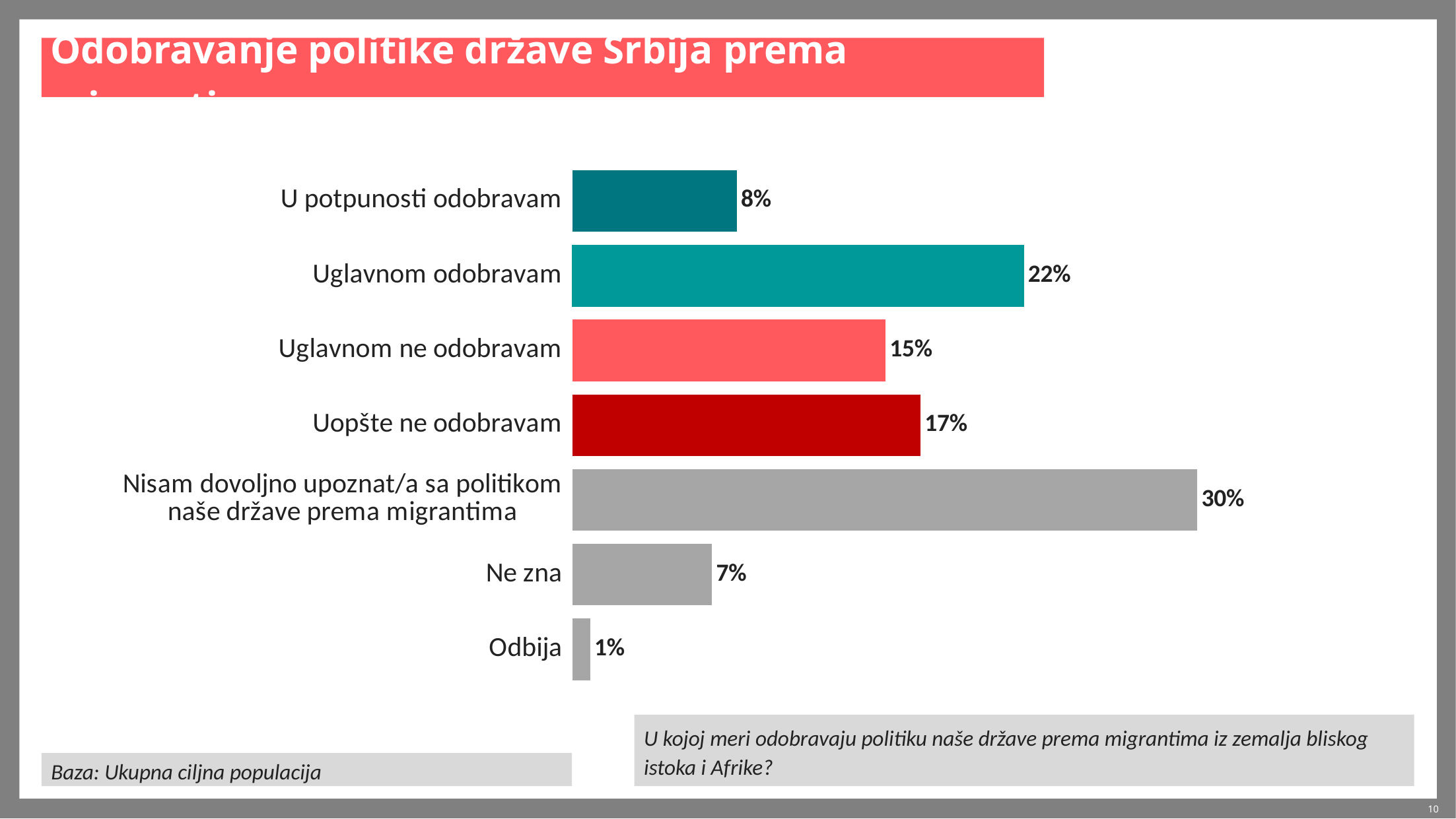
What is the value for "Ne zna"? 7% How many categories are shown in the chart? 7 Which category has the highest value? Nisam dovoljno upoznat/a sa politikom naše države prema migrantima What is the value for "Uglavnom odobravam"? 22% What kind of chart is shown on the slide? Bar chart Which category has the lowest value? Odbija What is the combined value of "U potpunosti odobravam" and "Uglavnom odobravam"? 30% What is the value for "U potpunosti odobravam"? 8% What is the value for "Uopšte ne odobravam"? 17% What colour is the bar for "Uopšte ne odobravam"? Dark red What is the difference between "Uglavnom odobravam" and "Uglavnom ne odobravam"? 7% Which is larger, "Uglavnom ne odobravam" or "Uopšte ne odobravam"? Uopšte ne odobravam